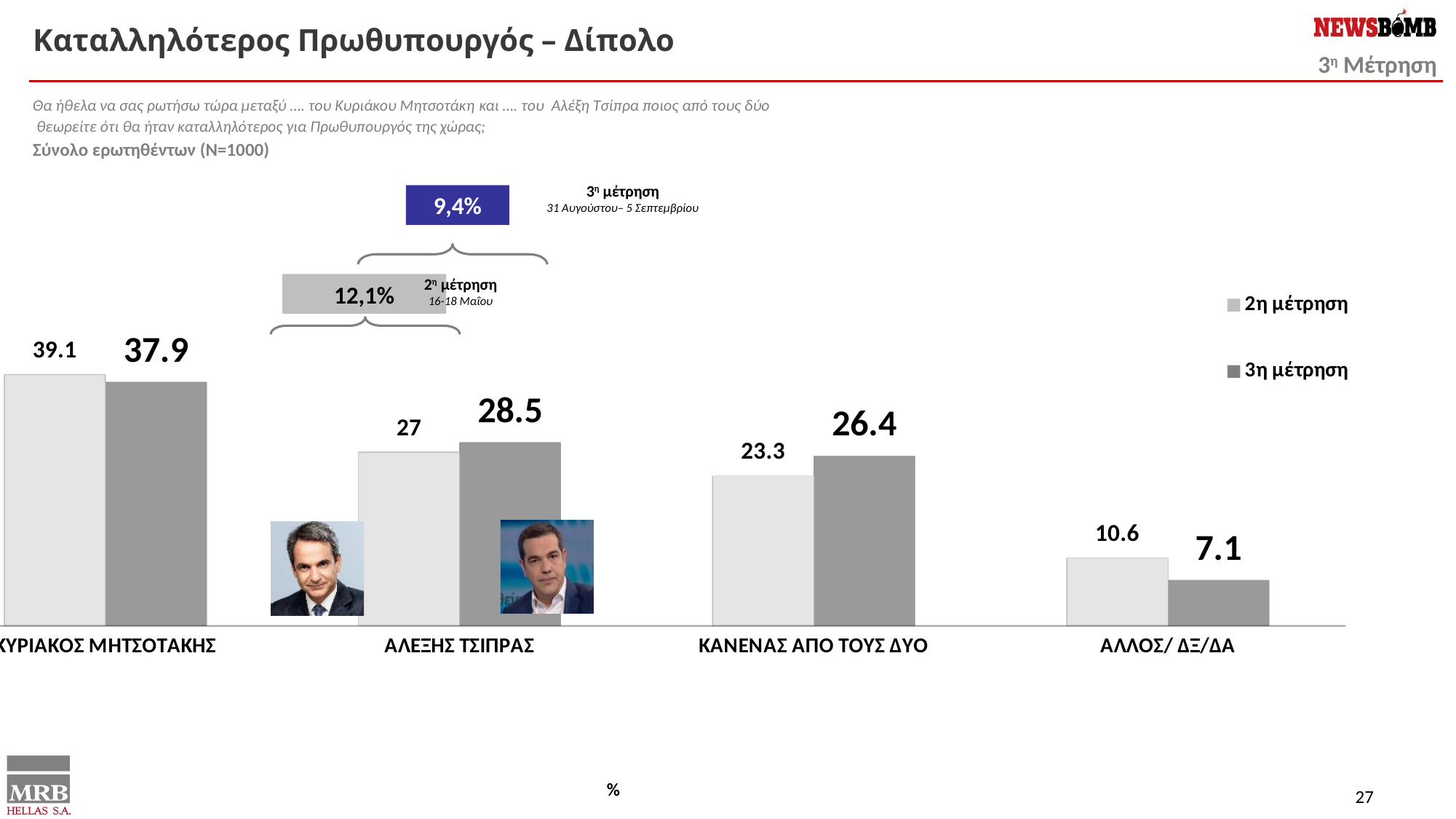
What is the value for ΑΛΛΟΣ/ ΔΞ/ΔΑ in the 3η μέτρηση series? 7.1 What kind of chart is shown on the slide? bar chart What is the value for ΚΥΡΙΑΚΟΣ ΜΗΤΣΟΤΑΚΗΣ in the 2η μέτρηση series? 39.1 How many categories are shown on the x axis of the chart? 4 Which category has the lowest value in the 2η μέτρηση series? ΑΛΛΟΣ/ ΔΞ/ΔΑ Which category has the highest value in the 3η μέτρηση series? ΚΥΡΙΑΚΟΣ ΜΗΤΣΟΤΑΚΗΣ What is the value for ΚΑΝΕΝΑΣ ΑΠΟ ΤΟΥΣ ΔΥΟ in the 2η μέτρηση series? 23.3 What is the value for ΑΛΕΞΗΣ ΤΣΙΠΡΑΣ in the 3η μέτρηση series? 28.5 What is the difference between the 2η μέτρηση and 3η μέτρηση values for ΑΛΛΟΣ/ ΔΞ/ΔΑ? 3.5 How many series does the legend list? 2 For ΚΑΝΕΝΑΣ ΑΠΟ ΤΟΥΣ ΔΥΟ, which series has the larger value, 2η μέτρηση or 3η μέτρηση? 3η μέτρηση What is the difference between the 3η μέτρηση values for ΚΥΡΙΑΚΟΣ ΜΗΤΣΟΤΑΚΗΣ and ΑΛΕΞΗΣ ΤΣΙΠΡΑΣ? 9.4